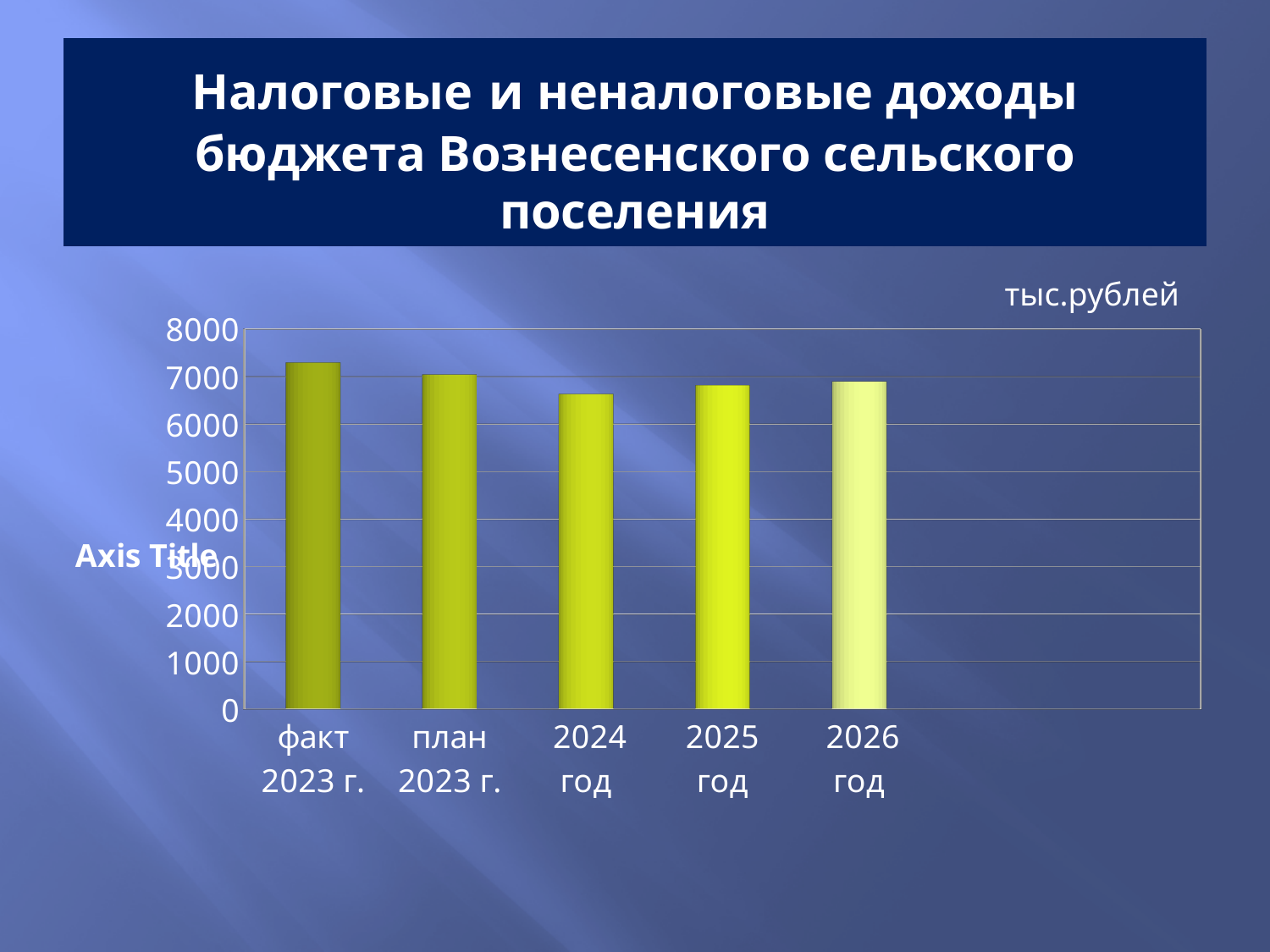
What is the title of the slide above the chart? Налоговые и неналоговые доходы бюджета Вознесенского сельского поселения Is the value for 2025 год greater or less than 6000? greater Is the value for 2024 год greater or less than 7000? less What kind of chart is shown on the slide? bar chart How many categories are shown on the x axis of the chart? 5 Is the value for факт 2023 г. greater or less than 7000? greater Do the values rise or fall from 2024 год to 2026 год? rise Which is larger, the value for факт 2023 г. or the value for 2024 год? факт 2023 г. Which is larger, the value for план 2023 г. or the value for 2024 год? план 2023 г. What unit label is shown above the chart? тыс.рублей Which category has the highest bar in the chart? факт 2023 г. Which category has the lowest bar in the chart? 2024 год